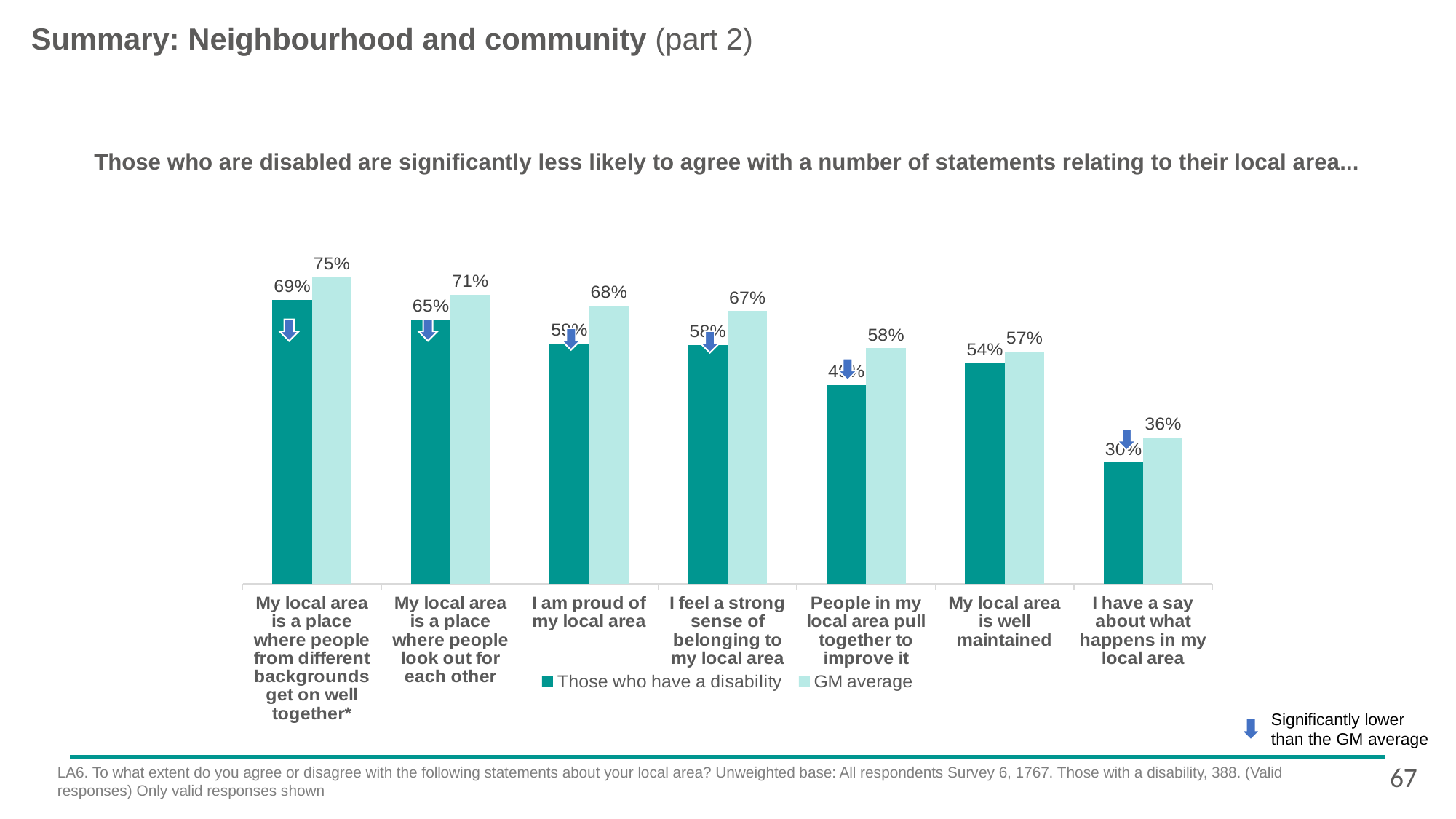
Which statement has the lowest value for "Those who have a disability"? I have a say about what happens in my local area How many statements (categories) are shown on the chart? 7 What is the GM average value for "I have a say about what happens in my local area"? 36% What is the difference between the GM average and the "Those who have a disability" value for "I feel a strong sense of belonging to my local area"? 9 percentage points What is the value for "Those who have a disability" for "I feel a strong sense of belonging to my local area"? 58% What is the difference between the GM average and the "Those who have a disability" value for "My local area is a place where people from different backgrounds get on well together*"? 6 percentage points How many series does the legend list? 2 What is the value for "Those who have a disability" for "My local area is a place where people look out for each other"? 65% For "My local area is well maintained", which is larger: the GM average or the value for those who have a disability? GM average What type of chart is shown on the slide? Bar chart Which statement has the highest GM average value? My local area is a place where people from different backgrounds get on well together* What is the GM average value for "My local area is well maintained"? 57%